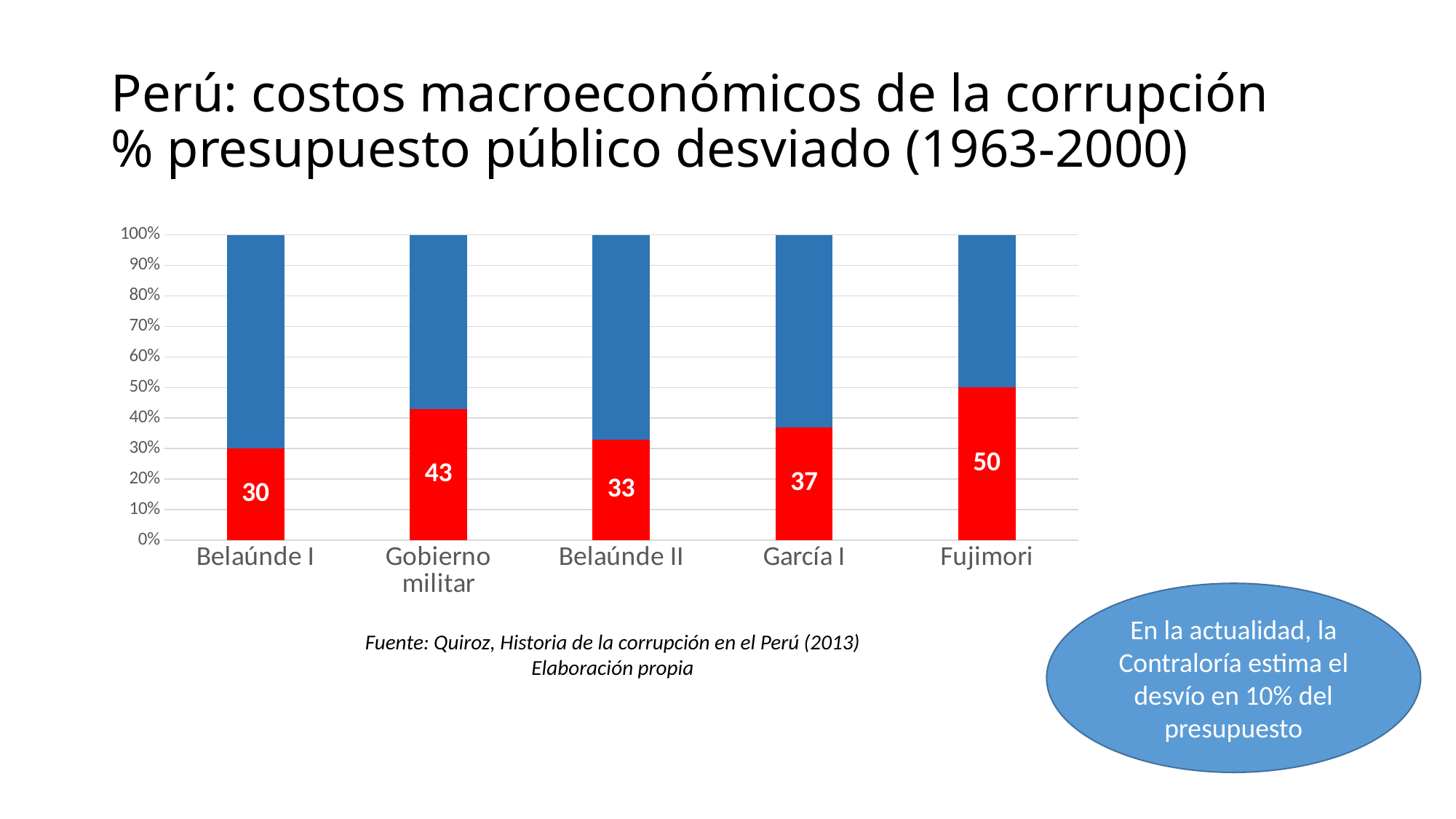
Which category has the highest labelled red value? Fujimori How many categories are shown on the x axis? 5 Is the blue segment for Belaúnde I greater or less than 60% of the bar? greater Which has a larger labelled red value, Gobierno militar or García I? Gobierno militar What is the labelled value of the red segment for Belaúnde II? 33 Which category has the lowest labelled red value? Belaúnde I What is the labelled value of the red segment for Belaúnde I? 30 What is the labelled value of the red segment for Gobierno militar? 43 What is the difference between the labelled red values for Fujimori and Belaúnde I? 20 What is the total height of each stacked bar according to the y axis? 100% What is the labelled value of the red segment for García I? 37 What kind of chart is shown on the slide? Stacked bar chart